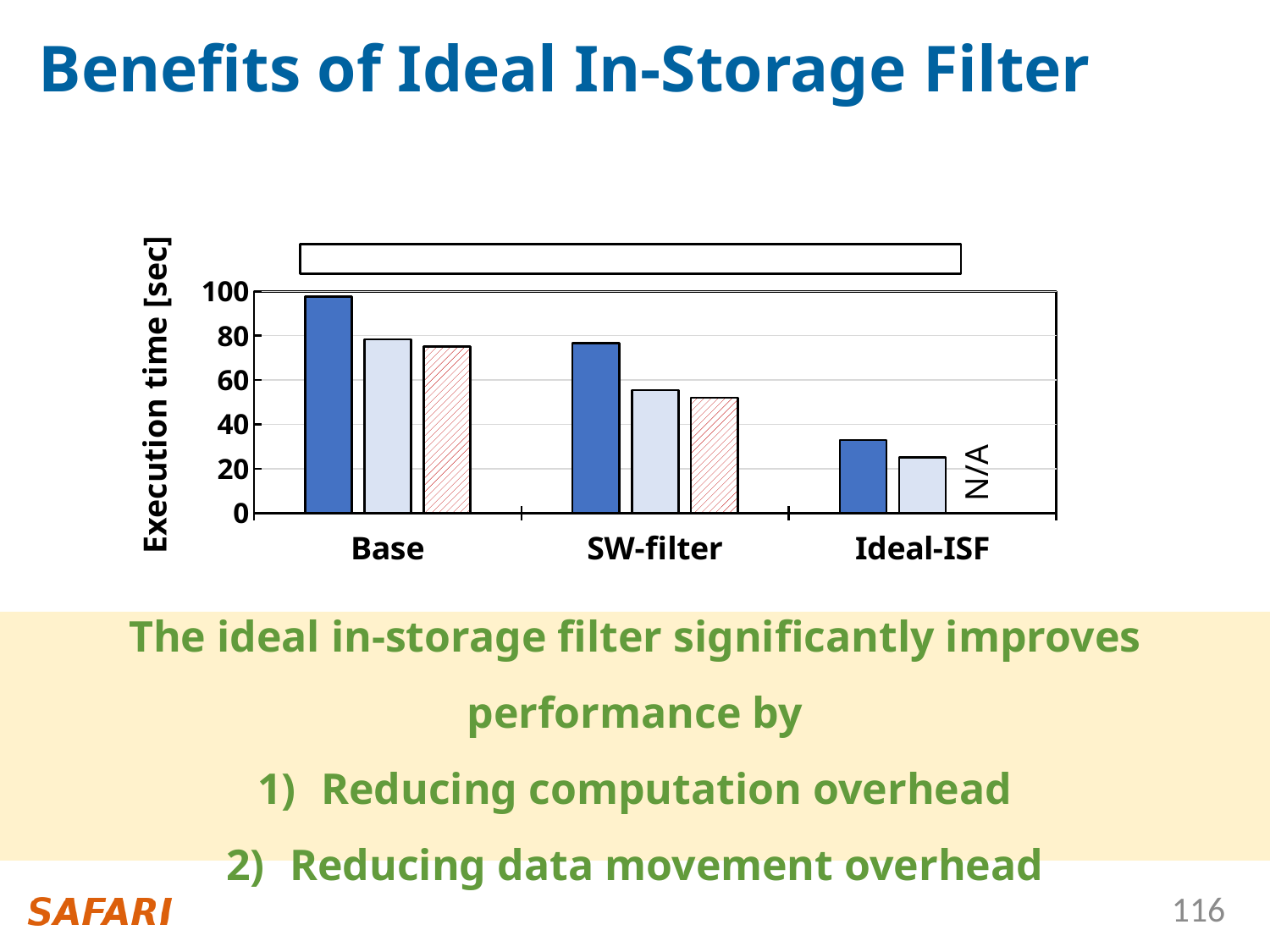
Which category has the lowest execution time bars in the chart? Ideal-ISF What is the label of the y axis of the chart? Execution time [sec] What is shown in place of the third (red hatched) bar for Ideal-ISF? N/A Which category has the tallest bar in the chart? Base What kind of chart is shown on the slide? bar chart Is the value of the dark blue bar for SW-filter greater or less than 60? greater Which has the larger dark blue bar, Base or SW-filter? Base Do the execution times rise or fall moving from Base to Ideal-ISF along the x axis? fall Is the value of the red hatched bar for SW-filter greater or less than 40? greater Is the value of the dark blue bar for Ideal-ISF greater or less than 40? less How many categories are shown on the x axis of the chart? 3